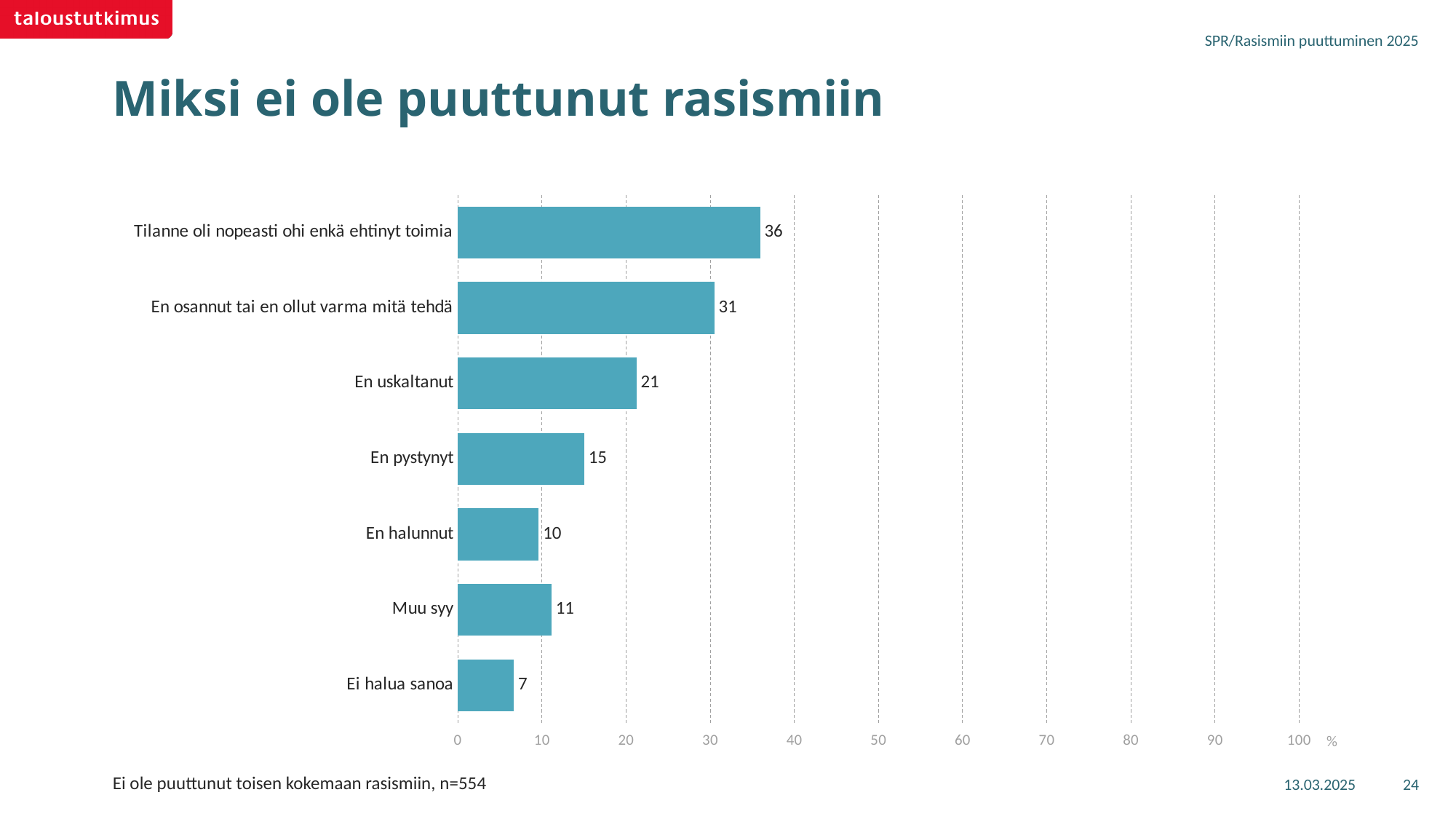
What is the value for "En uskaltanut"? 21 What is the difference between the values for "Tilanne oli nopeasti ohi enkä ehtinyt toimia" and "En osannut tai en ollut varma mitä tehdä"? 5 Which category has the lowest value? Ei halua sanoa Is the value for "En pystynyt" greater or less than 20? less What kind of chart is shown on the slide? bar chart How many categories are shown in the chart? 7 Which category has the highest value? Tilanne oli nopeasti ohi enkä ehtinyt toimia What is the sample size (n) stated below the chart? n=554 What is the value for "Ei halua sanoa"? 7 What is the title of the slide? Miksi ei ole puuttunut rasismiin Which is larger, the value for "En halunnut" or the value for "Muu syy"? Muu syy What is the value for "Tilanne oli nopeasti ohi enkä ehtinyt toimia"? 36